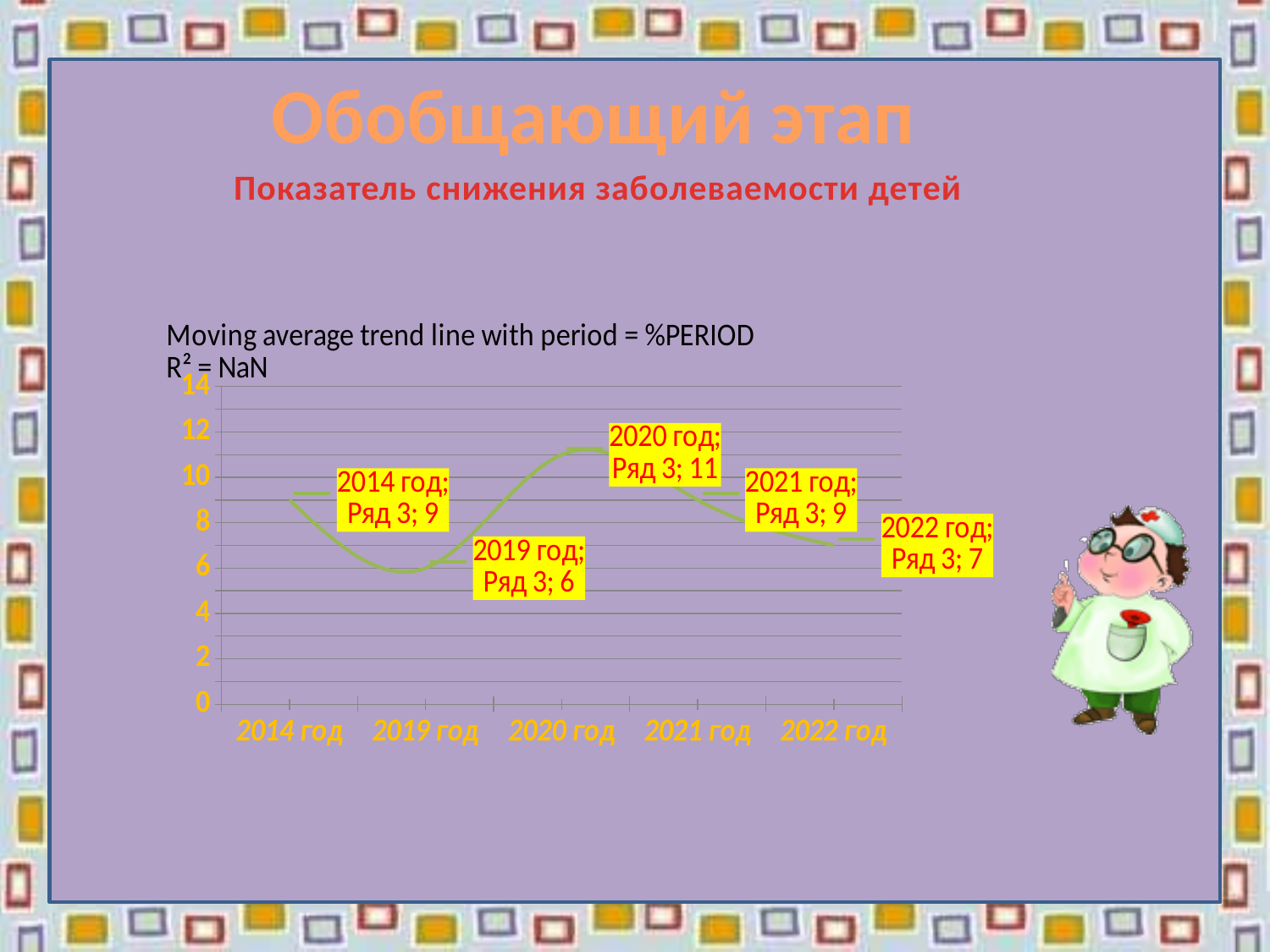
Is the value for 2020 год greater or less than 10? greater What is the name of the data series shown in the data labels? Ряд 3 What is the value for 2022 год? 7 Which is larger, the value for 2014 год or the value for 2022 год? 2014 год Which year has the highest value? 2020 год Which year has the lowest value? 2019 год What kind of chart is shown? line chart What is the value for 2020 год? 11 What is the value for 2019 год? 6 What is the difference between the values for 2020 год and 2019 год? 5 Do the values rise or fall from 2021 год to 2022 год? fall How many years are plotted on the x axis? 5